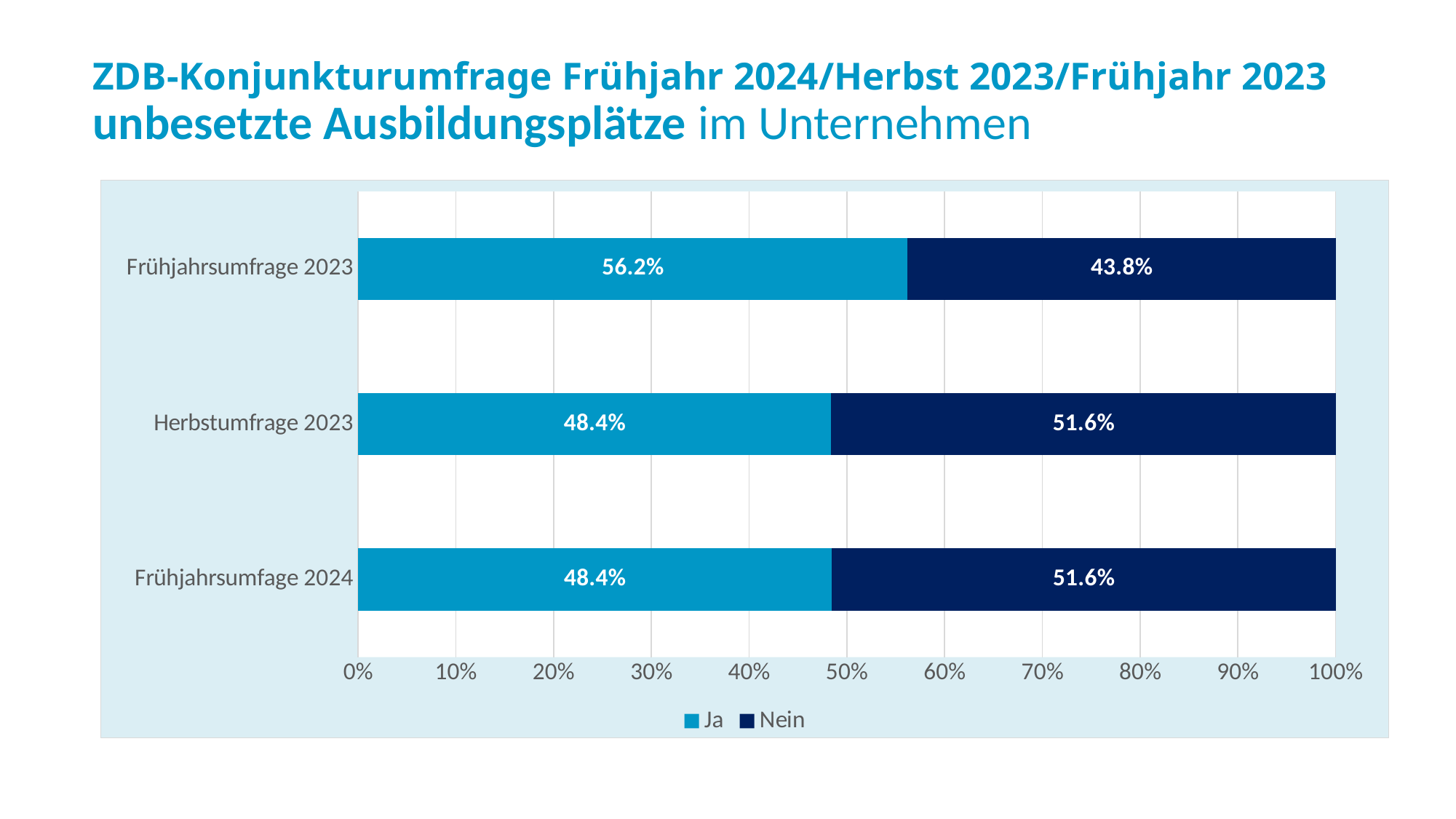
What is the 'Ja' value for Frühjahrsumfrage 2023? 56.2% Which survey has the lowest 'Nein' value? Frühjahrsumfrage 2023 What is the difference between the 'Ja' values for Frühjahrsumfrage 2023 and Herbstumfrage 2023? 7.8% What is the 'Nein' value for Herbstumfrage 2023? 51.6% Is the 'Ja' value for Frühjahrsumfrage 2023 greater or less than 50%? greater Which is larger for Frühjahrsumfage 2024: the 'Ja' value or the 'Nein' value? Nein What kind of chart is shown on the slide? Stacked bar chart What is the 'Ja' value for Frühjahrsumfage 2024? 48.4% Which survey has the highest 'Ja' value? Frühjahrsumfrage 2023 How many series does the legend list? 2 How many surveys are shown on the chart? 3 What is the 'Nein' value for Frühjahrsumfrage 2023? 43.8%